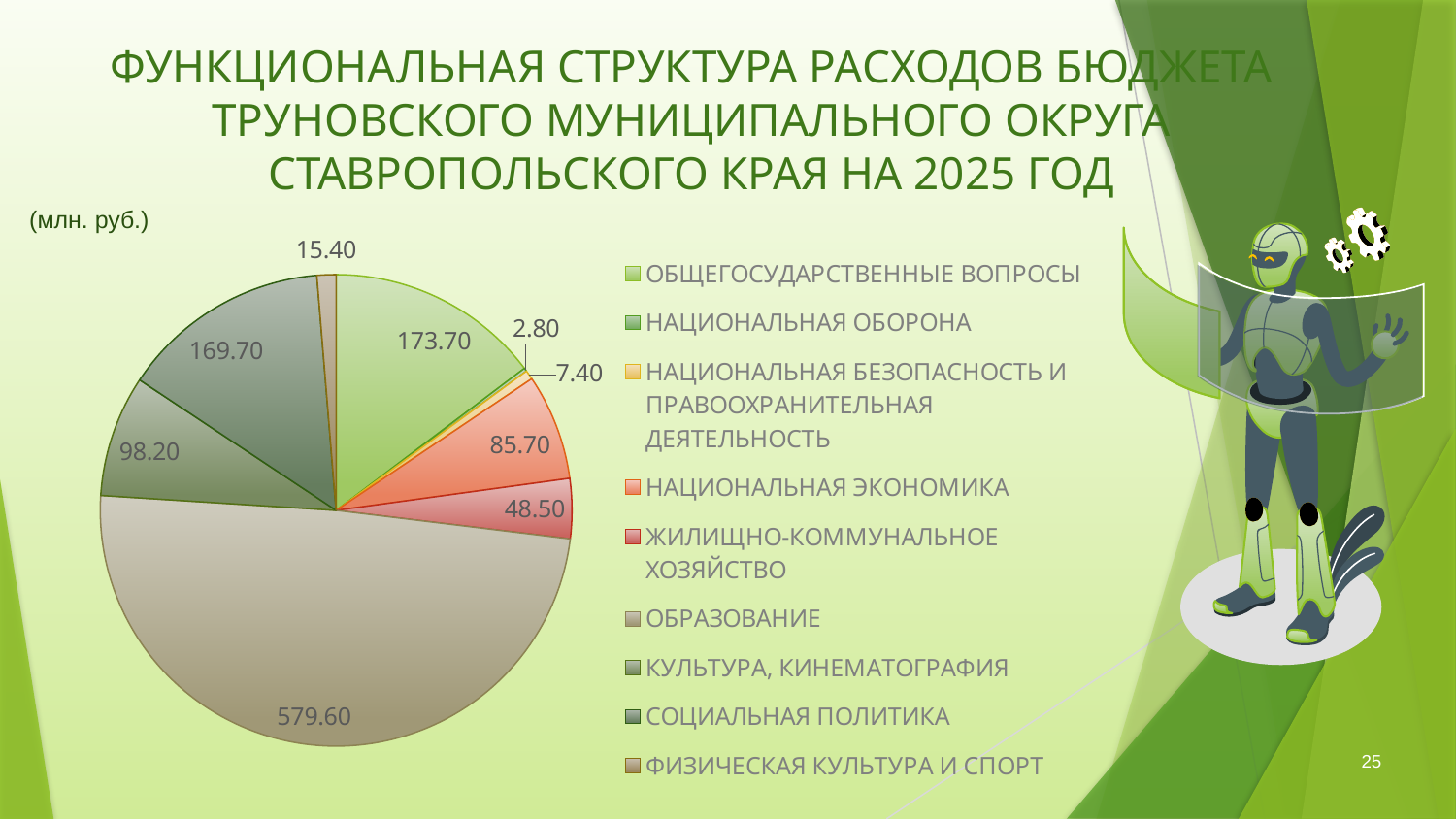
Which category has the largest slice of the pie? ОБРАЗОВАНИЕ What is the value for СОЦИАЛЬНАЯ ПОЛИТИКА? 169.70 Which is larger, the value for КУЛЬТУРА, КИНЕМАТОГРАФИЯ or the value for НАЦИОНАЛЬНАЯ ЭКОНОМИКА? КУЛЬТУРА, КИНЕМАТОГРАФИЯ Which category has the smallest slice of the pie? НАЦИОНАЛЬНАЯ ОБОРОНА What is the difference between the values for ОБЩЕГОСУДАРСТВЕННЫЕ ВОПРОСЫ and СОЦИАЛЬНАЯ ПОЛИТИКА? 4.00 What unit is indicated for the values in the chart? млн. руб. What is the value for НАЦИОНАЛЬНАЯ ЭКОНОМИКА? 85.70 What is the value for НАЦИОНАЛЬНАЯ ОБОРОНА? 2.80 What is the value for ОБРАЗОВАНИЕ? 579.60 What kind of chart is shown on the slide? pie chart How many categories does the pie chart have? 9 What is the difference between the values for ЖИЛИЩНО-КОММУНАЛЬНОЕ ХОЗЯЙСТВО and ФИЗИЧЕСКАЯ КУЛЬТУРА И СПОРТ? 33.10